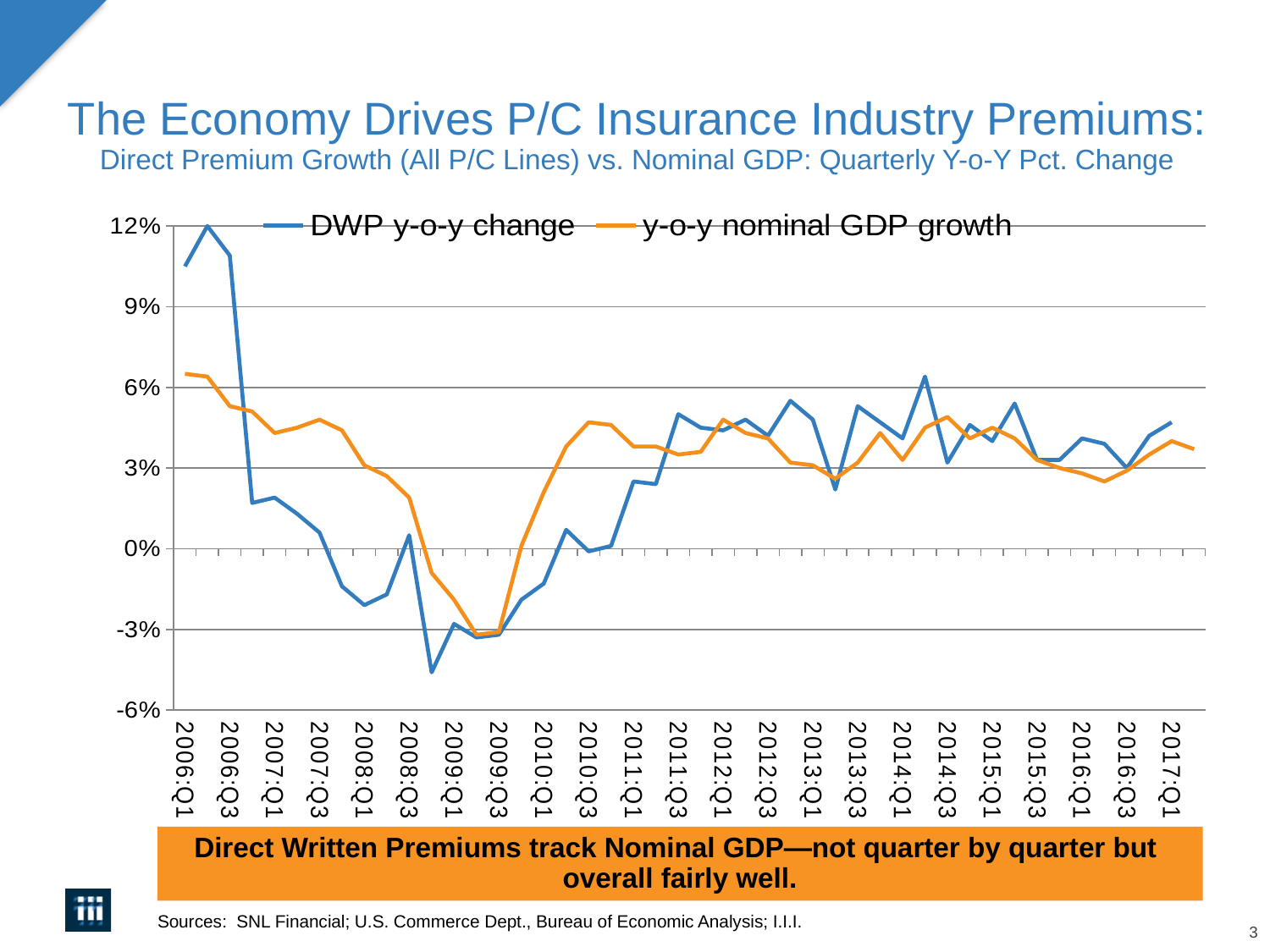
Is the DWP y-o-y change value for 2006:Q3 greater or less than 9%? greater What kind of chart is shown on the slide? Line chart At 2010:Q3, which series has the higher value, DWP y-o-y change or y-o-y nominal GDP growth? y-o-y nominal GDP growth How many series does the legend list? 2 Which series reaches the lowest value anywhere on the chart? DWP y-o-y change What are the two series named in the legend? DWP y-o-y change; y-o-y nominal GDP growth At 2006:Q1, which series has the higher value, DWP y-o-y change or y-o-y nominal GDP growth? DWP y-o-y change Is the y-o-y nominal GDP growth value for 2009:Q1 greater or less than 0%? less What colour is the line for y-o-y nominal GDP growth? Orange Is the y-o-y nominal GDP growth value for 2006:Q1 greater or less than 6%? greater Does the DWP y-o-y change line rise or fall between 2006:Q3 and 2009:Q1? Fall